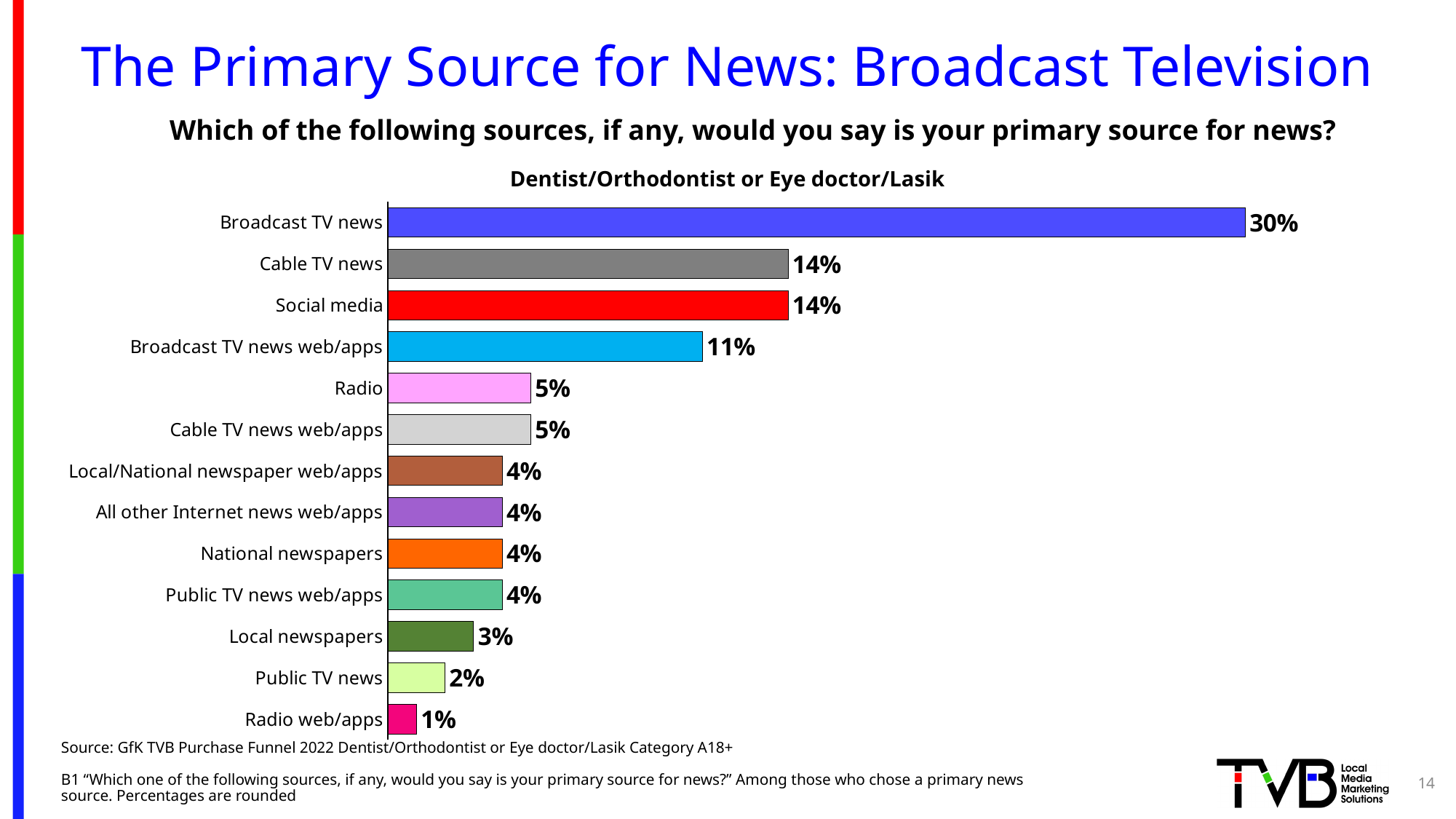
What percentage of respondents named Broadcast TV news as their primary source for news? 30% Which news source has the lowest percentage on the chart? Radio web/apps What is the difference in percentage points between Broadcast TV news and Cable TV news? 16 Which news source has the highest percentage on the chart? Broadcast TV news Which has a larger value, Social media or Radio? Social media What percentage is shown for Radio web/apps? 1% What type of chart is shown on the slide? Bar chart How many news sources are listed on the chart? 13 What is the difference in percentage points between Broadcast TV news web/apps and Public TV news? 9 What is the title shown directly above the chart? Dentist/Orthodontist or Eye doctor/Lasik What is the value for Local newspapers? 3% What is the value shown for Broadcast TV news web/apps? 11%